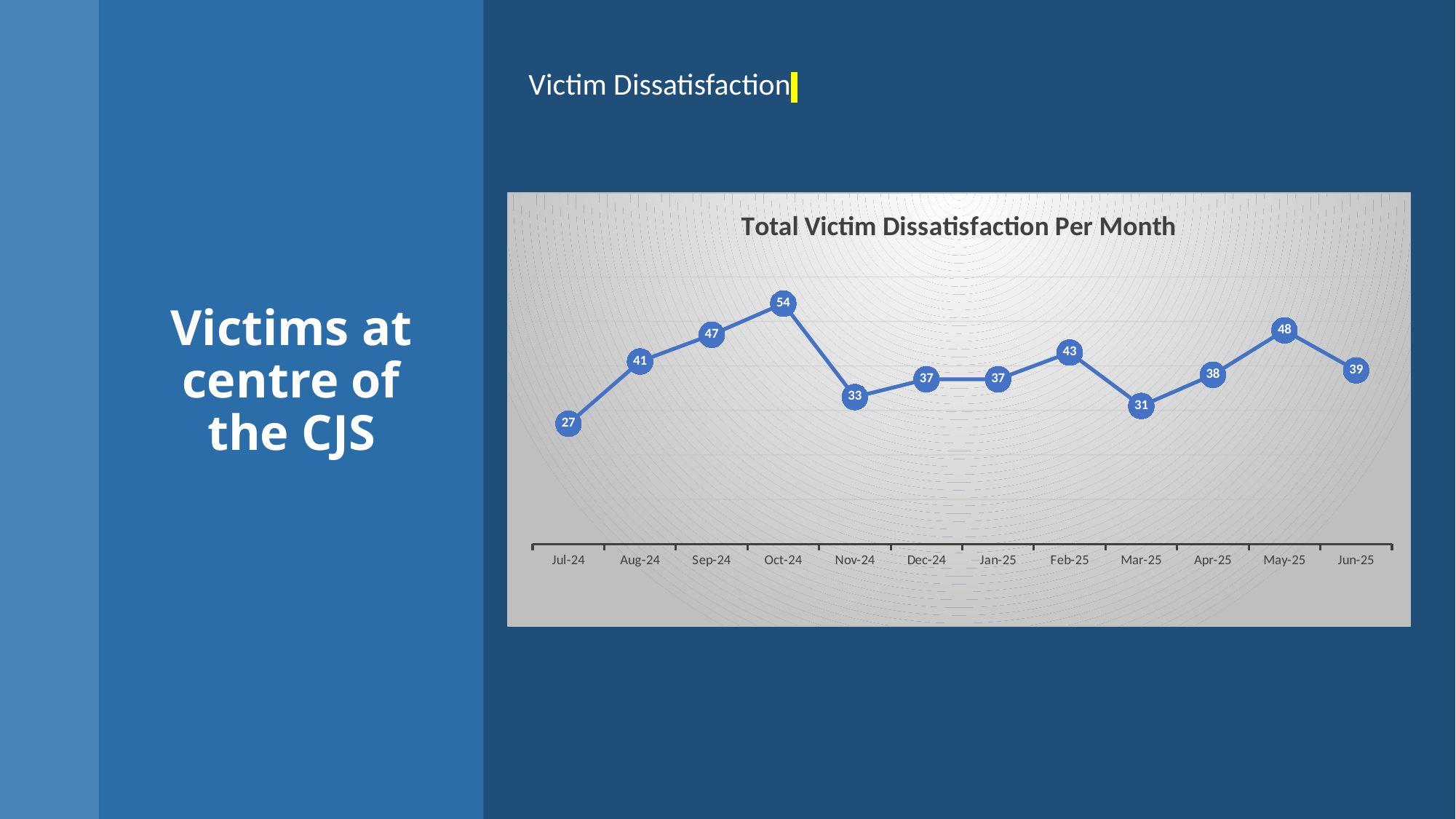
What is the value for Oct-24? 54 What is the value for Jun-25? 39 How many months are plotted on the chart? 12 Do the values rise or fall from Jul-24 to Oct-24? Rise What kind of chart is shown? Line chart What is the value for Jul-24? 27 What is the difference between the values for Oct-24 and Nov-24? 21 What is the title of the chart? Total Victim Dissatisfaction Per Month Which month has the highest value? Oct-24 Which is larger, the value for May-25 or the value for Feb-25? May-25 What is the value for Mar-25? 31 Which month has the lowest value? Jul-24